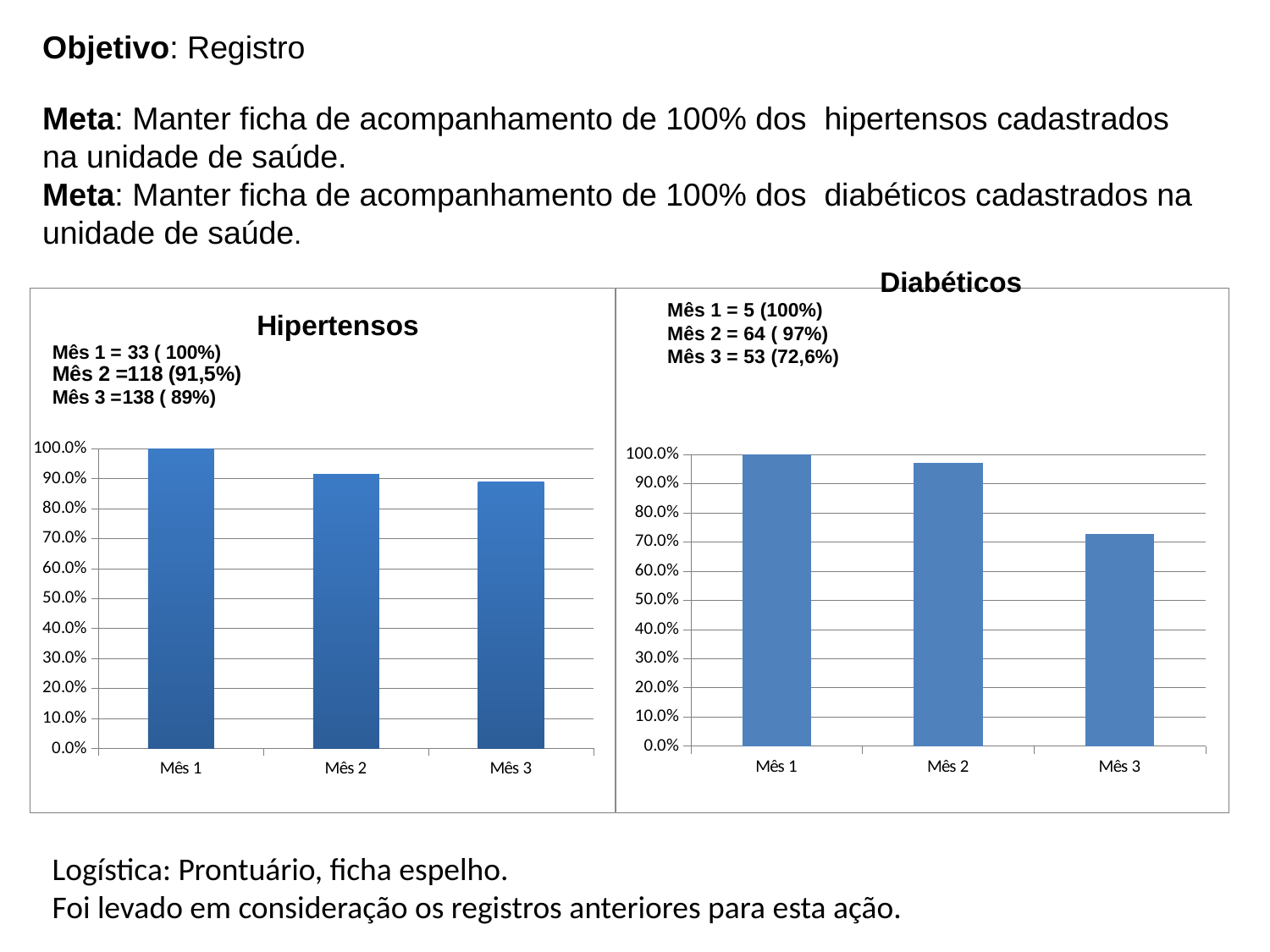
In the Hipertensos chart, is the value for Mês 2 greater or less than 90.0%? greater In the Diabéticos chart, is the value for Mês 3 greater or less than 80.0%? less In the Diabéticos chart, what percentage is shown for Mês 3? 72,6% In the Diabéticos chart, which month has the highest bar? Mês 1 In the Hipertensos chart, what percentage is shown for Mês 2? 91,5% What is the title of the chart on the left side of the slide? Hipertensos In the Hipertensos chart, how many months are plotted on the x axis? 3 In the Diabéticos chart, what percentage is shown for Mês 2? 97% In the Hipertensos chart, what percentage is shown for Mês 1? 100% What kind of chart is the Diabéticos chart? Bar chart In the Diabéticos chart, do the values rise or fall from Mês 1 to Mês 3? Fall In the Hipertensos chart, which month has the lowest bar? Mês 3